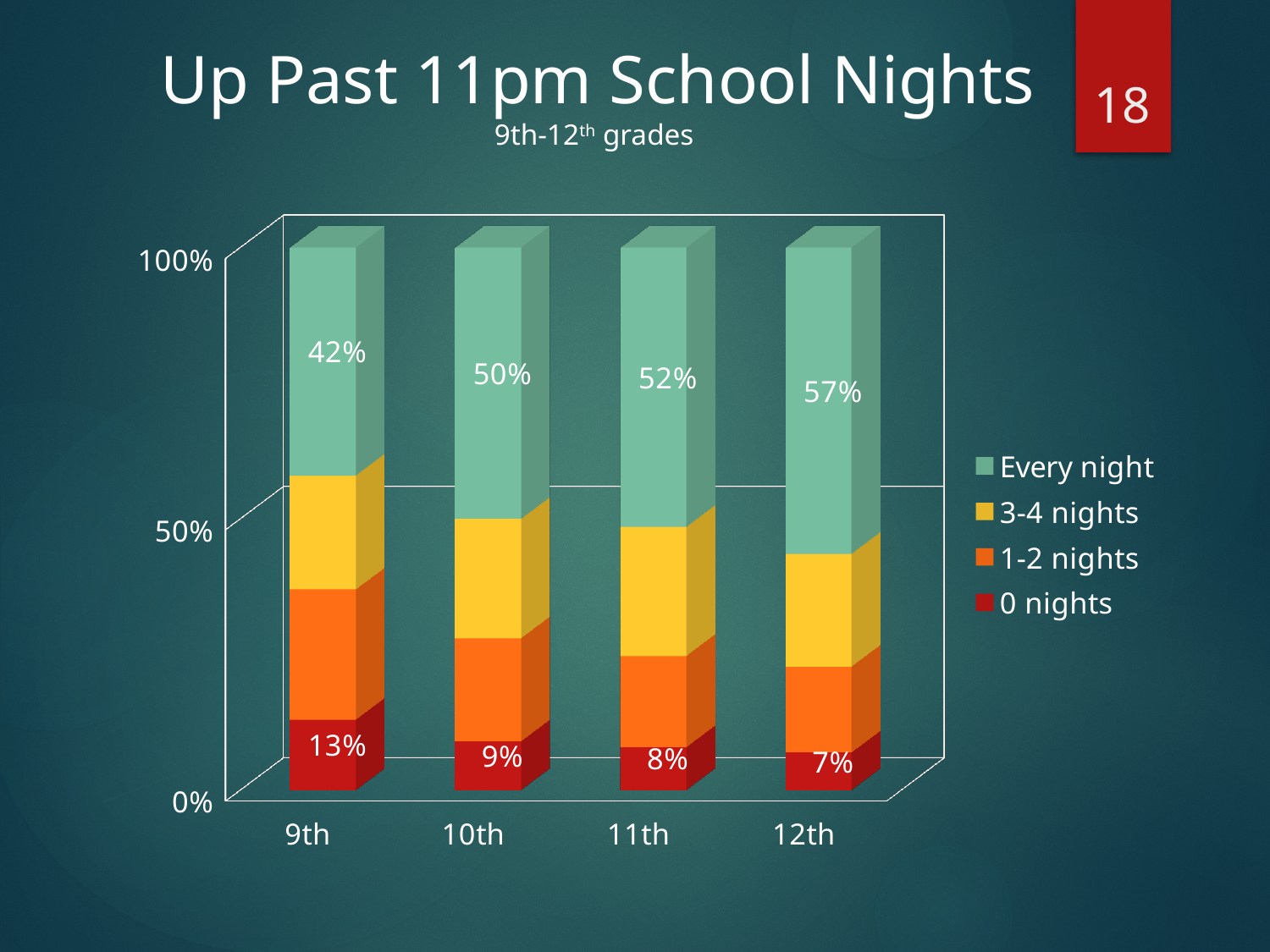
What is the value for '0 nights' for 12th grade? 7% What is the difference between the 'Every night' values for 12th grade and 9th grade? 15% What is the value for 'Every night' for 9th grade? 42% How many series does the legend list? 4 How many grade categories are shown on the x axis? 4 Which grade has the highest value for 'Every night'? 12th What is the value for 'Every night' for 11th grade? 52% Does the 'Every night' value rise or fall from 9th to 12th grade? rise What kind of chart is shown on the slide? stacked bar chart Which is larger: the '0 nights' value for 9th grade or for 11th grade? 9th grade Which grade has the lowest value for '0 nights'? 12th What is the value for '0 nights' for 10th grade? 9%